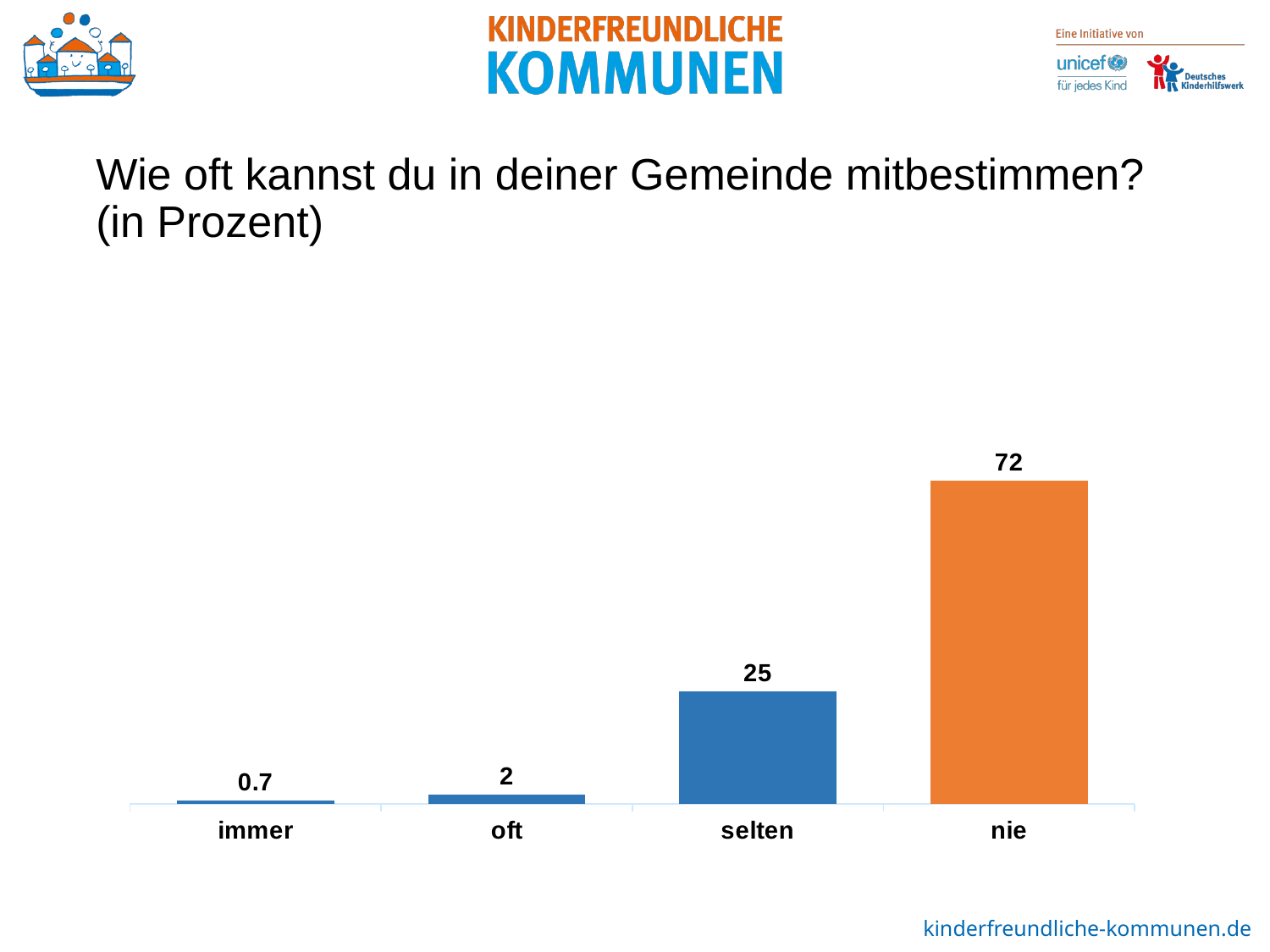
What is the value for "nie"? 72 Which bar is coloured orange? nie Which category has the highest value? nie What kind of chart is shown on the slide? bar chart What is the value for "immer"? 0.7 What is the value for "selten"? 25 What is the value for "oft"? 2 What is the difference between the values for "nie" and "selten"? 47 Which is larger, the value for "selten" or the value for "oft"? selten How many categories are shown on the x axis? 4 Which category has the lowest value? immer What is the difference between the values for "oft" and "immer"? 1.3